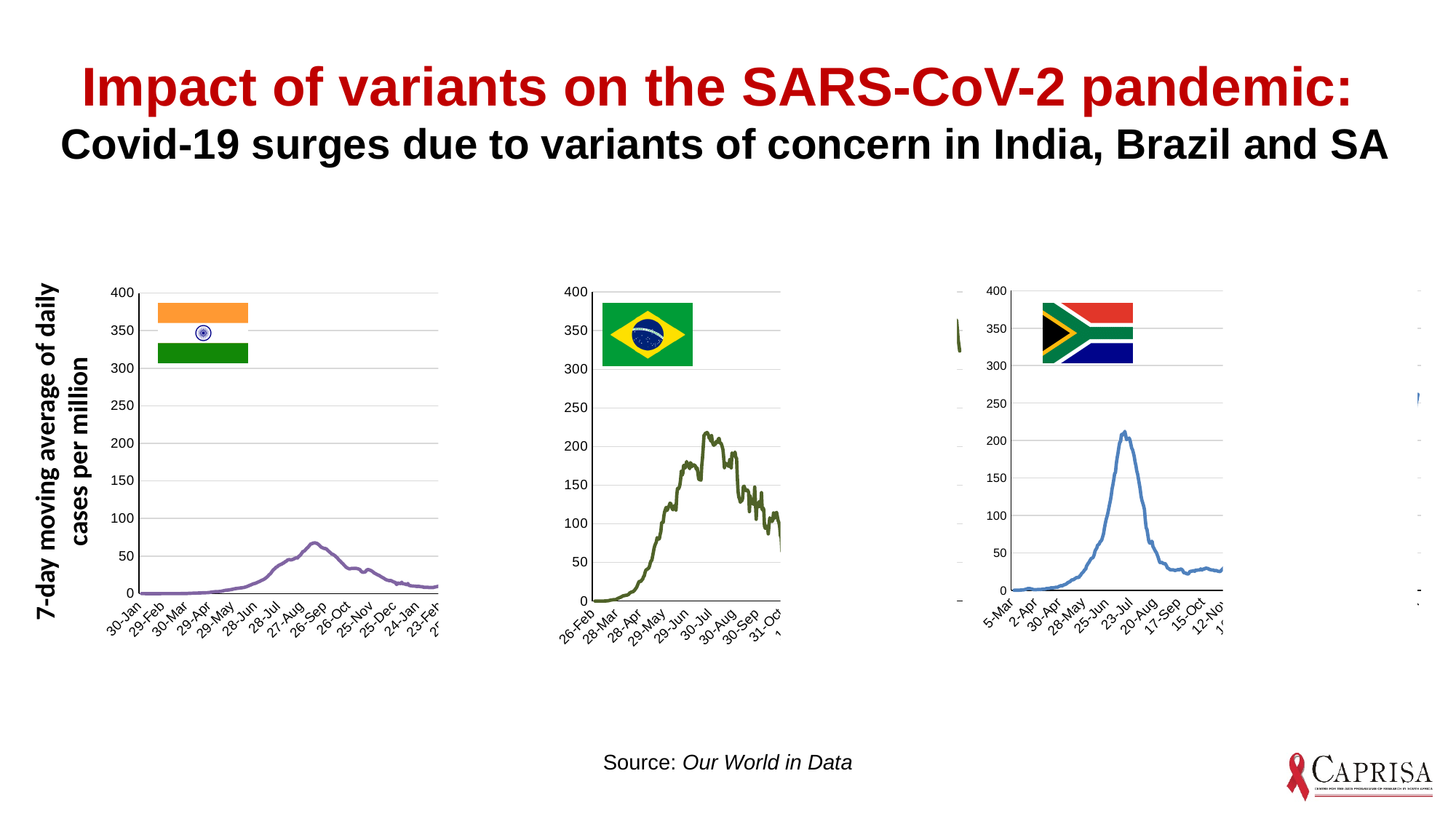
In the right-hand chart with the South African flag, do the values rise or fall between 28-May and 23-Jul? rise What kind of chart is the left-hand chart with the Indian flag? line chart How many charts are shown on the slide? 3 What is the maximum value shown on the y axis of the middle chart with the Brazilian flag? 400 In the middle chart with the Brazilian flag, is the peak value greater or less than 200? greater In the left-hand chart with the Indian flag, is the peak value greater or less than 100? less Which chart shows a higher peak: the left-hand chart with the Indian flag or the middle chart with the Brazilian flag? the middle chart with the Brazilian flag What is the y-axis label shared by the three charts? 7-day moving average of daily cases per million What is the first date label on the x axis of the middle chart with the Brazilian flag? 26-Feb In the right-hand chart with the South African flag, is the peak value greater or less than 150? greater Which chart shows a lower peak: the left-hand chart with the Indian flag or the right-hand chart with the South African flag? the left-hand chart with the Indian flag In the left-hand chart with the Indian flag, do the values rise or fall between 26-Sep and 23-Feb? fall